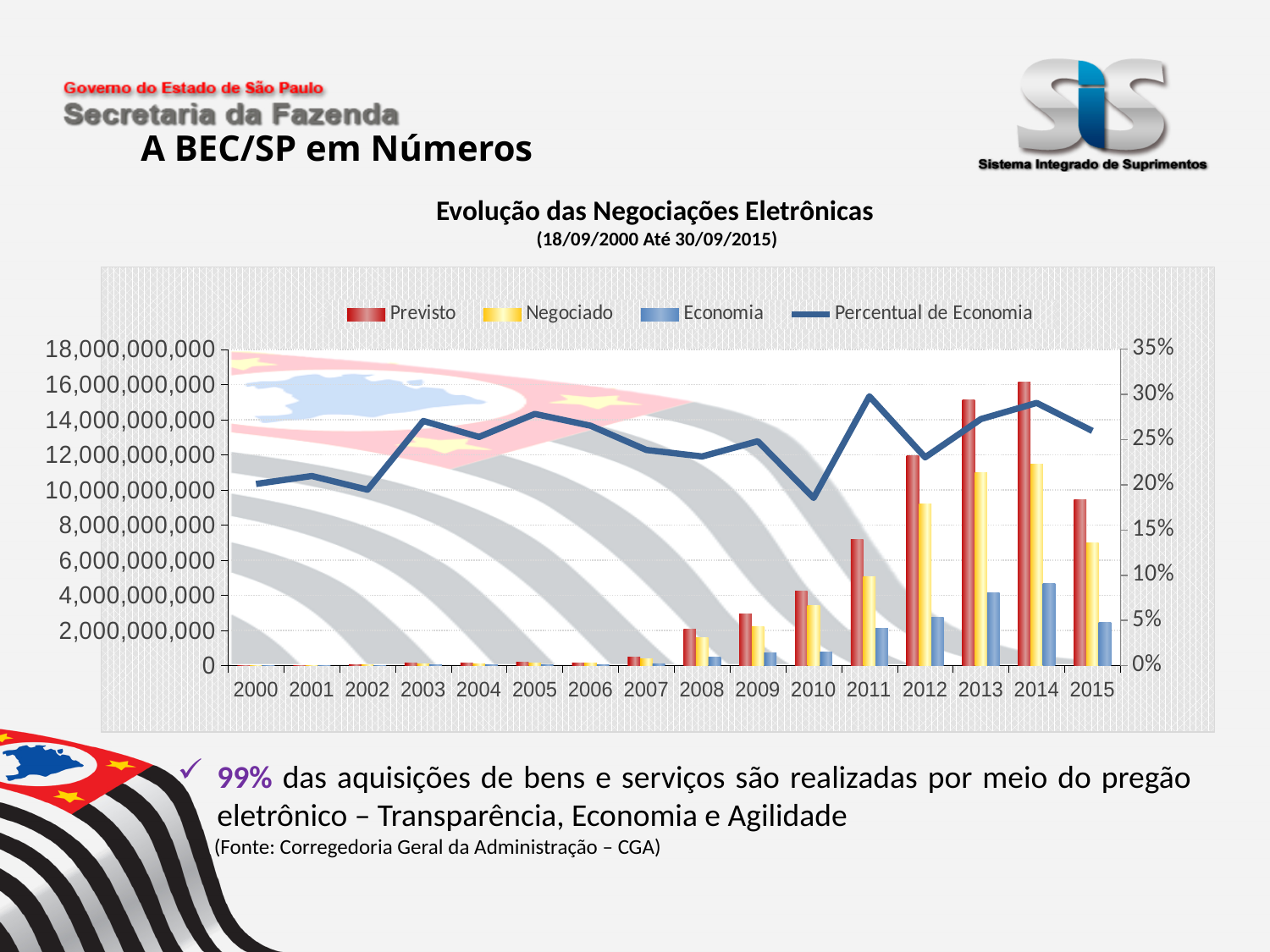
Which is larger, the Previsto value for 2014 or for 2015? 2014 In which year is the Previsto bar the highest? 2014 What kind of chart is shown on the slide? A combined bar and line chart Which series is plotted as a line rather than bars? Percentual de Economia Is the Percentual de Economia for 2011 greater or less than 25%? greater Do the Previsto bars generally rise or fall from 2000 to 2014? rise Is the Negociado value for 2012 greater or less than 10,000,000,000? less How many series does the chart legend list? 4 Is the Economia value for 2014 greater or less than 6,000,000,000? less What is the title of the chart? Evolução das Negociações Eletrônicas How many years are shown along the x axis of the chart? 16